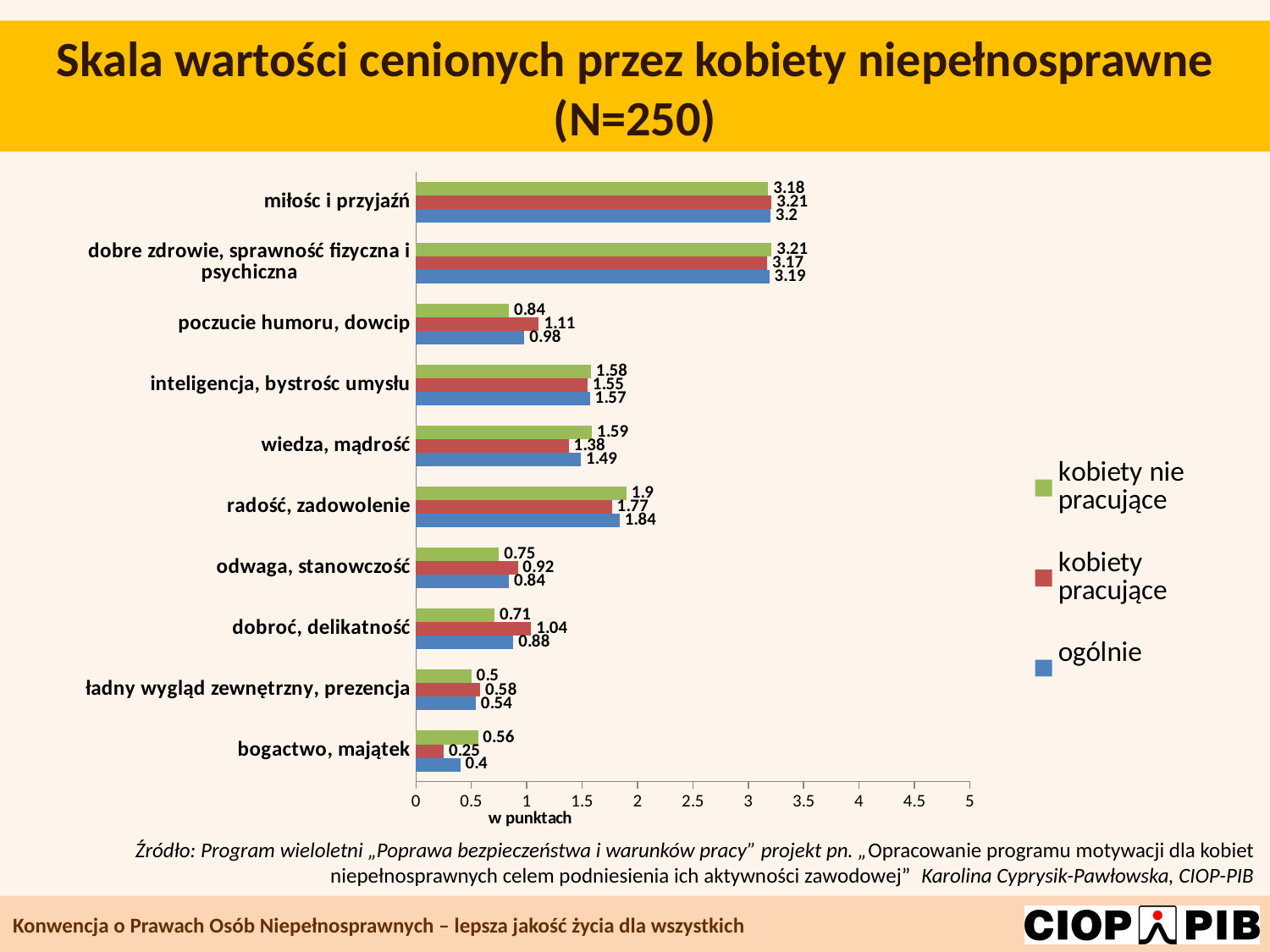
What is the label of the horizontal axis? w punktach What is the value for "kobiety pracujące" in the category "dobroć, delikatność"? 1.04 What kind of chart is shown on the slide? bar chart Which category has the lowest value for "ogólnie"? bogactwo, majątek What is the value for "ogólnie" in the category "radość, zadowolenie"? 1.84 Which category has the lowest value for "kobiety pracujące"? bogactwo, majątek How many categories are shown on the chart? 10 For "poczucie humoru, dowcip", which series has the larger value: "kobiety pracujące" or "kobiety nie pracujące"? kobiety pracujące Is the "ogólnie" value for "radość, zadowolenie" greater or less than 1.5? greater How many series does the legend list? 3 What is the difference between the "kobiety nie pracujące" and "kobiety pracujące" values for "radość, zadowolenie"? 0.13 What is the value for "kobiety nie pracujące" in the category "wiedza, mądrość"? 1.59